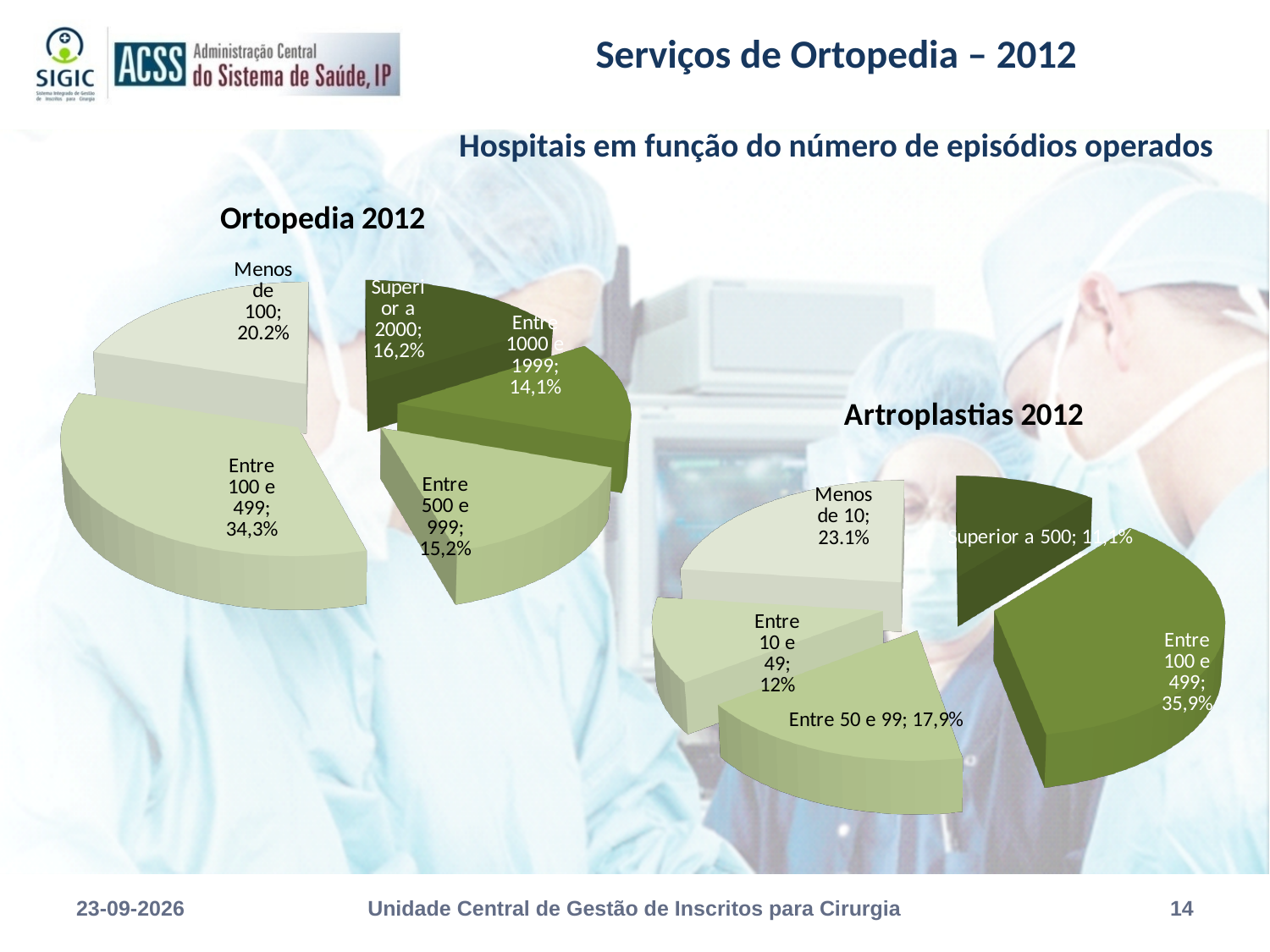
In the Ortopedia 2012 chart, which category has the largest share? Entre 100 e 499 In the Ortopedia 2012 chart, which category has the smallest share? Entre 1000 e 1999 In the Artroplastias 2012 chart, which category has the largest share? Entre 100 e 499 In the Ortopedia 2012 chart, what is the value for 'Menos de 100'? 20.2% In the Ortopedia 2012 chart, how many slices does the pie have? 5 In the Artroplastias 2012 chart, what is the value for 'Entre 50 e 99'? 17,9% In the Ortopedia 2012 chart, which is larger: 'Entre 500 e 999' or 'Entre 1000 e 1999'? Entre 500 e 999 What type of chart is the Artroplastias 2012 chart? Pie chart In the Artroplastias 2012 chart, how many slices does the pie have? 5 In the Ortopedia 2012 chart, what is the value for 'Superior a 2000'? 16,2% In the Ortopedia 2012 chart, what share of hospitals had between 100 and 499 episodes? 34,3% In the Artroplastias 2012 chart, what is the value for 'Entre 100 e 499'? 35,9%